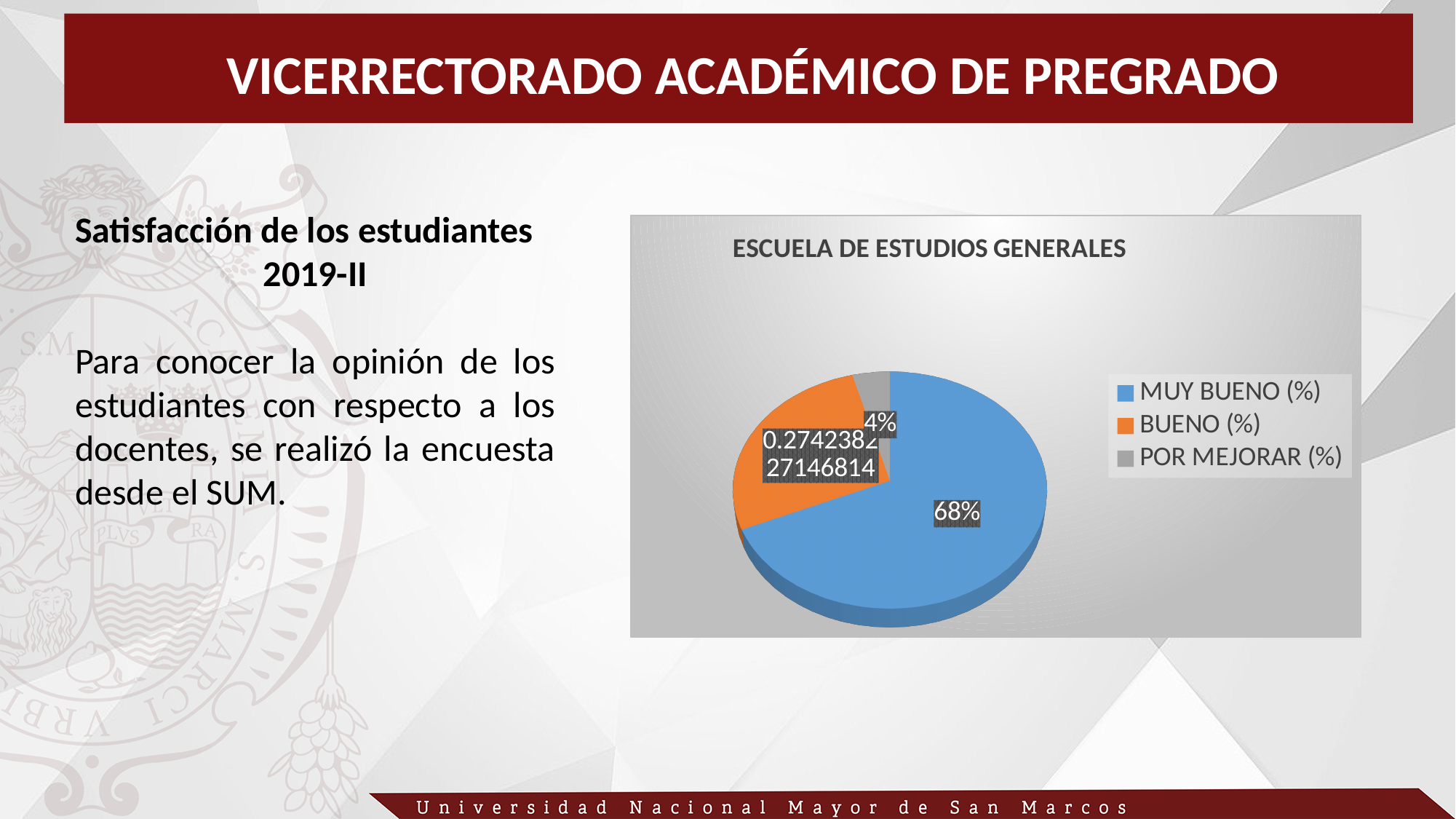
What colour is the slice for BUENO (%)? Orange What kind of chart is shown on the slide? Pie chart Which category has the largest slice of the pie? MUY BUENO (%) What is the value shown for POR MEJORAR (%)? 4% Is the share of the pie for MUY BUENO (%) greater or less than half? greater What is the value shown for MUY BUENO (%)? 68% What is the difference between the MUY BUENO (%) value and the POR MEJORAR (%) value? 64 percentage points What is the title of the chart? ESCUELA DE ESTUDIOS GENERALES How many entries does the chart's legend list? 3 Which category has the smallest slice of the pie? POR MEJORAR (%) Which is larger, the slice for BUENO (%) or the slice for POR MEJORAR (%)? BUENO (%) How many slices does the pie chart have? 3